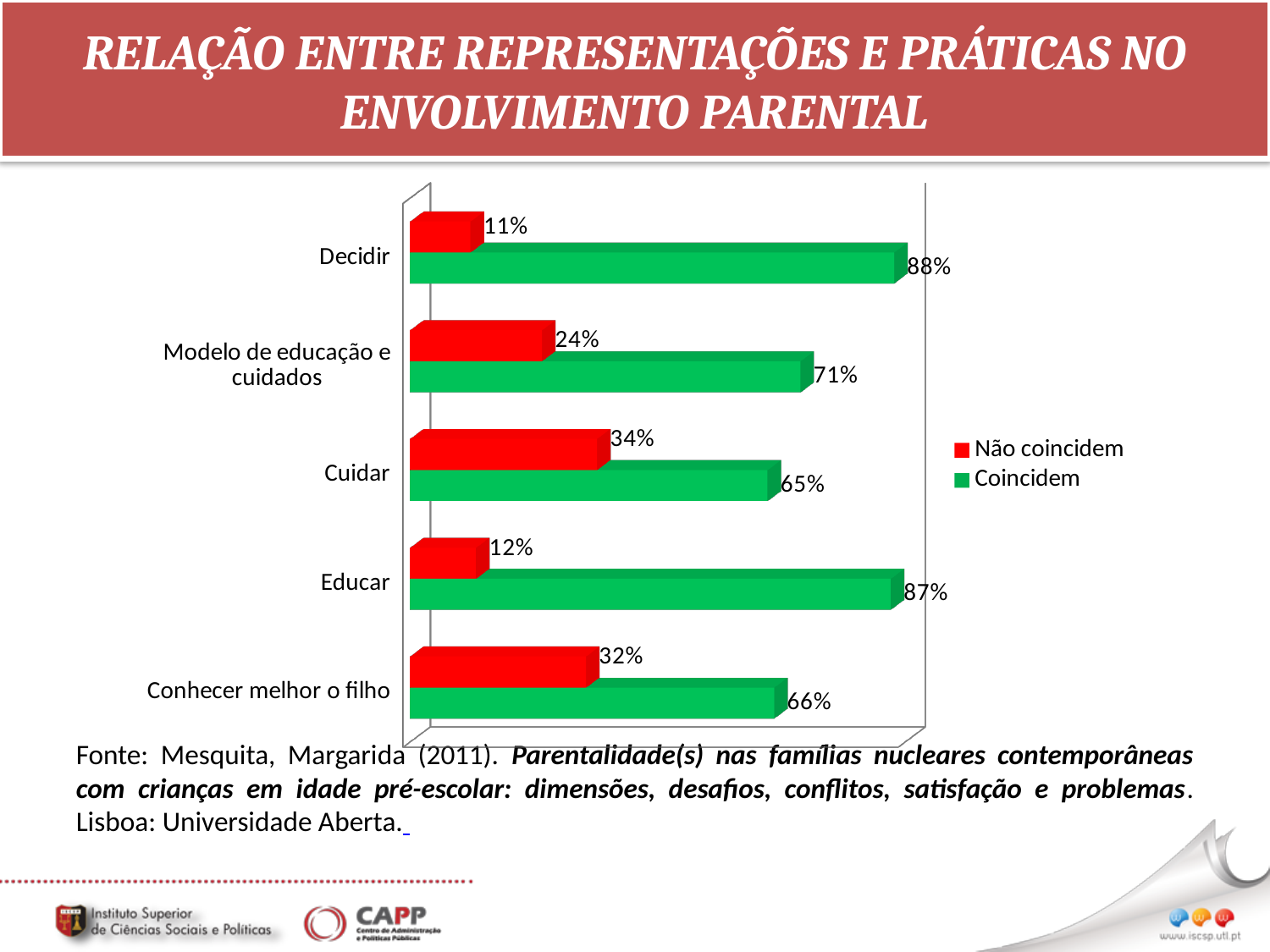
Which is larger: the 'Não coincidem' value for Cuidar or for Educar? Cuidar What is the 'Não coincidem' value for Cuidar? 34% What is the 'Não coincidem' value for Conhecer melhor o filho? 32% Which category has the highest 'Coincidem' value? Decidir How many categories are shown on the chart? 5 What is the 'Coincidem' value for Decidir? 88% Which colour represents the 'Coincidem' series? Green Which category has the lowest 'Não coincidem' value? Decidir What kind of chart is shown on the slide? Bar chart What is the 'Coincidem' value for Modelo de educação e cuidados? 71% What is the difference between the 'Coincidem' and 'Não coincidem' values for Educar? 75% How many series does the legend list? 2